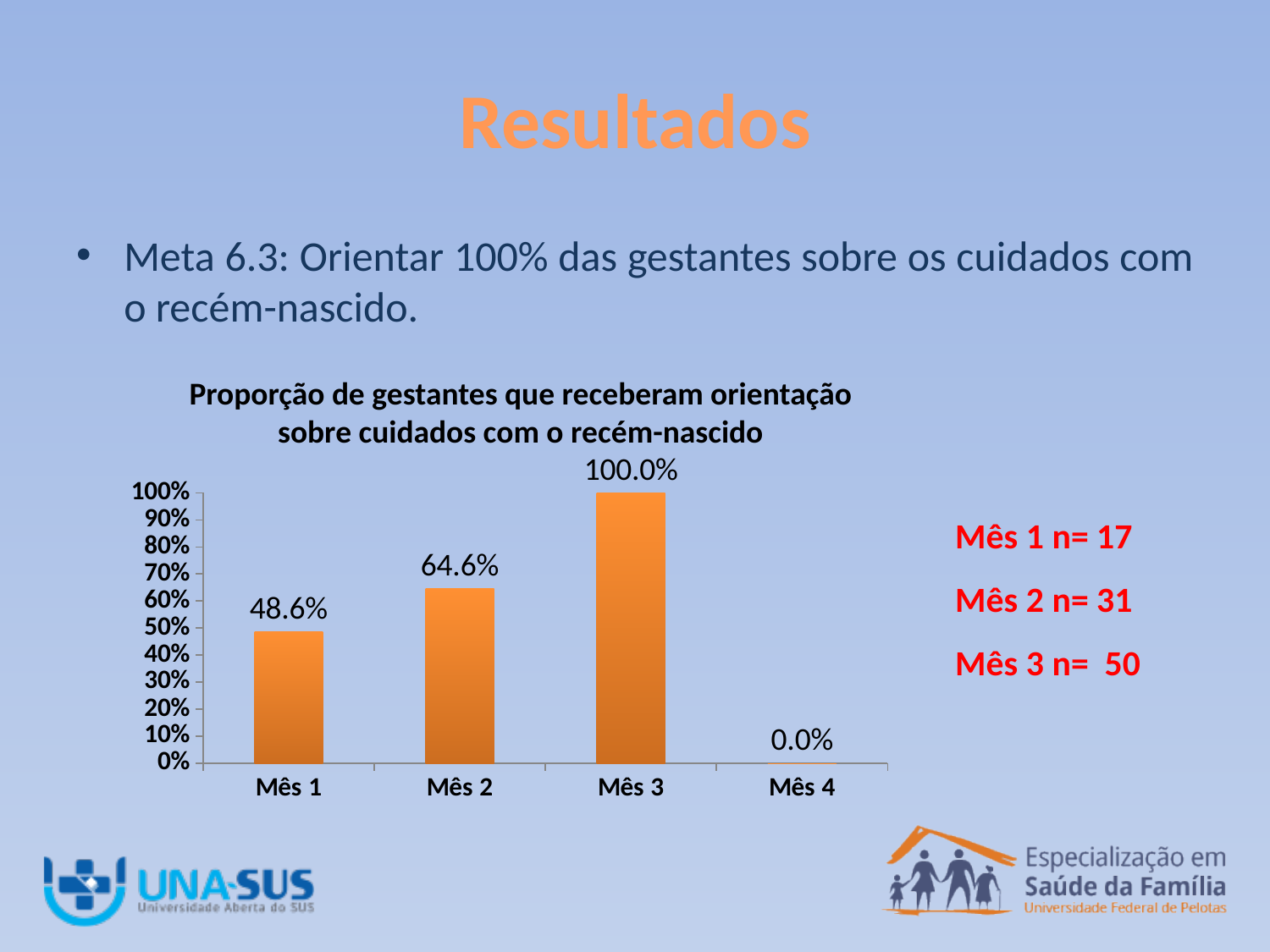
What is the value for Mês 2? 64.6% Is the value for Mês 1 greater or less than 50%? less What is the value for Mês 1? 48.6% What kind of chart is shown? bar chart Which is larger, the value for Mês 1 or the value for Mês 2? Mês 2 Which month has the highest value? Mês 3 What is the difference between the values for Mês 2 and Mês 1? 16.0% What is the value for Mês 4? 0.0% Which month has the lowest value? Mês 4 What is the title of the chart? Proporção de gestantes que receberam orientação sobre cuidados com o recém-nascido How many months are shown on the x axis? 4 What is the value for Mês 3? 100.0%